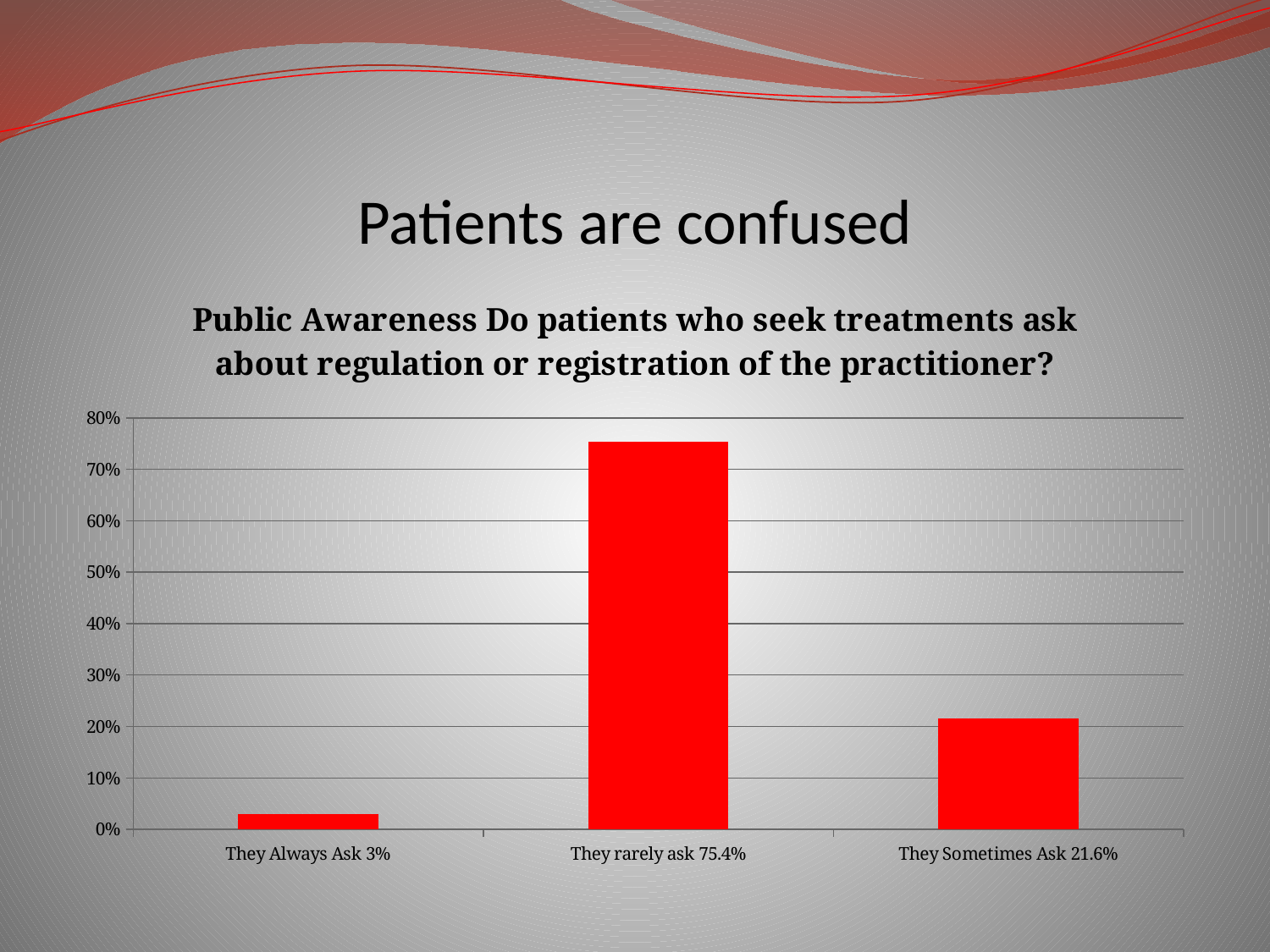
Which is larger: the percentage who sometimes ask or the percentage who always ask? They Sometimes Ask What is the difference between the percentage who sometimes ask and the percentage who always ask? 18.6% Which category has the lowest value in the chart? They Always Ask What percentage of patients rarely ask about regulation or registration of the practitioner? 75.4% What percentage of patients always ask about regulation or registration of the practitioner? 3% What is the difference between the percentage who rarely ask and the percentage who sometimes ask? 53.8% How many categories are shown in the chart? 3 Which category has the highest value in the chart? They rarely ask What percentage of patients sometimes ask about regulation or registration of the practitioner? 21.6% What kind of chart is shown on the slide? Bar chart Is the value for 'They rarely ask' greater or less than 70%? greater What is the highest value shown on the vertical axis of the chart? 80%